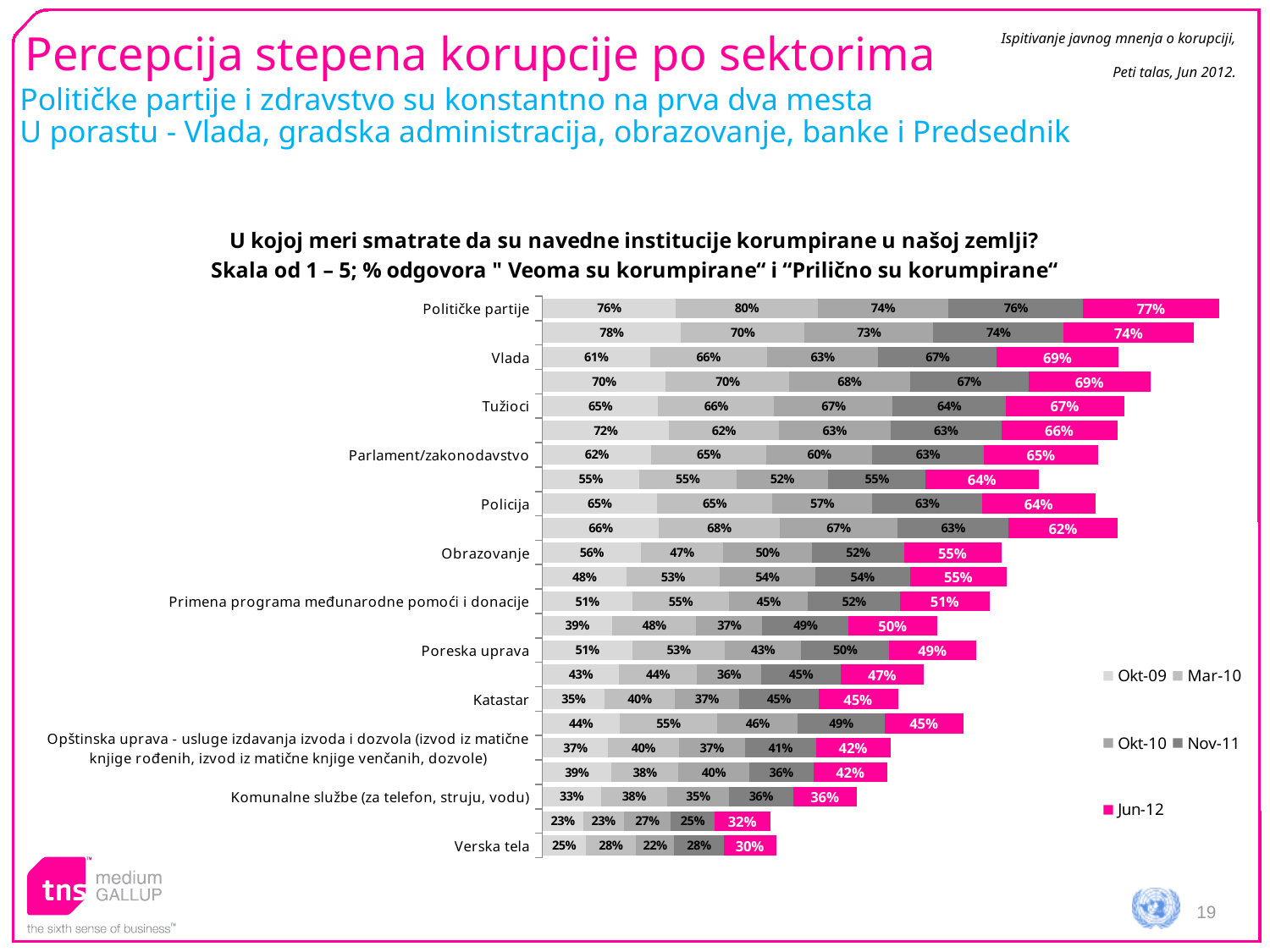
How many series does the legend list? 5 What is the Nov-11 value for Policija? 63% What is the Jun-12 value for Verska tela? 30% What is the Okt-09 value for Vlada? 61% Which series is shown in pink/magenta in the legend? Jun-12 Which labelled category has the lowest Jun-12 value? Verska tela What is the difference between the Jun-12 values for Političke partije and Verska tela? 47 percentage points Which has the larger Jun-12 value, Vlada or Tužioci? Vlada Which labelled category has the highest Jun-12 value? Političke partije What is the Jun-12 value for Političke partije? 77% What kind of chart is shown on the slide? Stacked bar chart What is the Mar-10 value for Obrazovanje? 47%